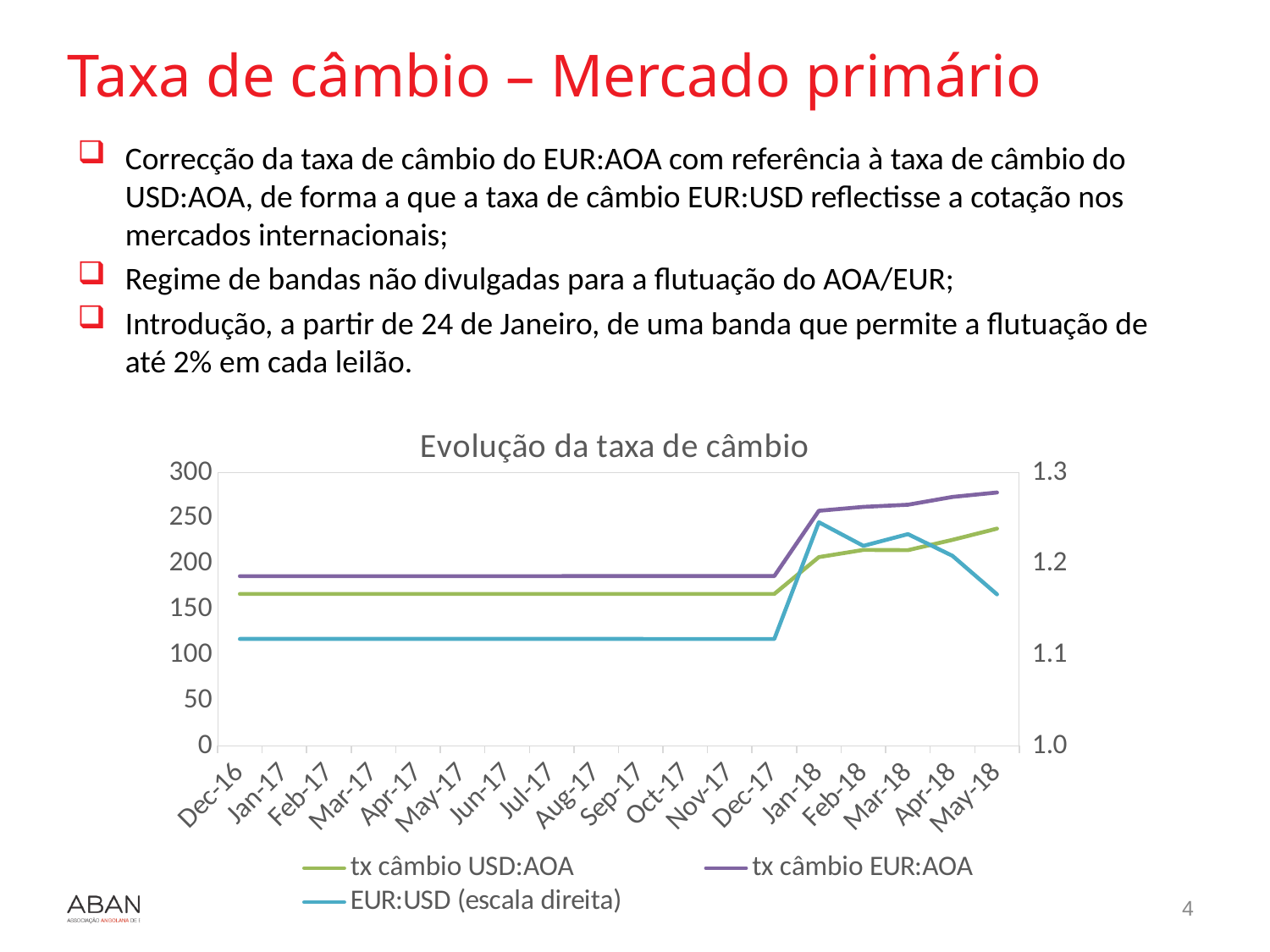
How many months are plotted along the x axis of the chart? 18 Is the value for tx câmbio EUR:AOA in Dec-17 greater or less than 200? less Is the value for tx câmbio USD:AOA in May-18 greater or less than 200? greater How many series does the legend of the chart list? 3 What kind of chart is shown on the slide? line chart In May-18, which is higher, tx câmbio USD:AOA or tx câmbio EUR:AOA? tx câmbio EUR:AOA Which month has the highest value for tx câmbio EUR:AOA? May-18 Is the value for tx câmbio EUR:AOA in May-18 greater or less than 250? greater Which series in the chart is plotted on the right-hand axis? EUR:USD (escala direita) What is the title of the chart? Evolução da taxa de câmbio Does the EUR:USD (escala direita) series rise or fall from Jan-18 to May-18? fall